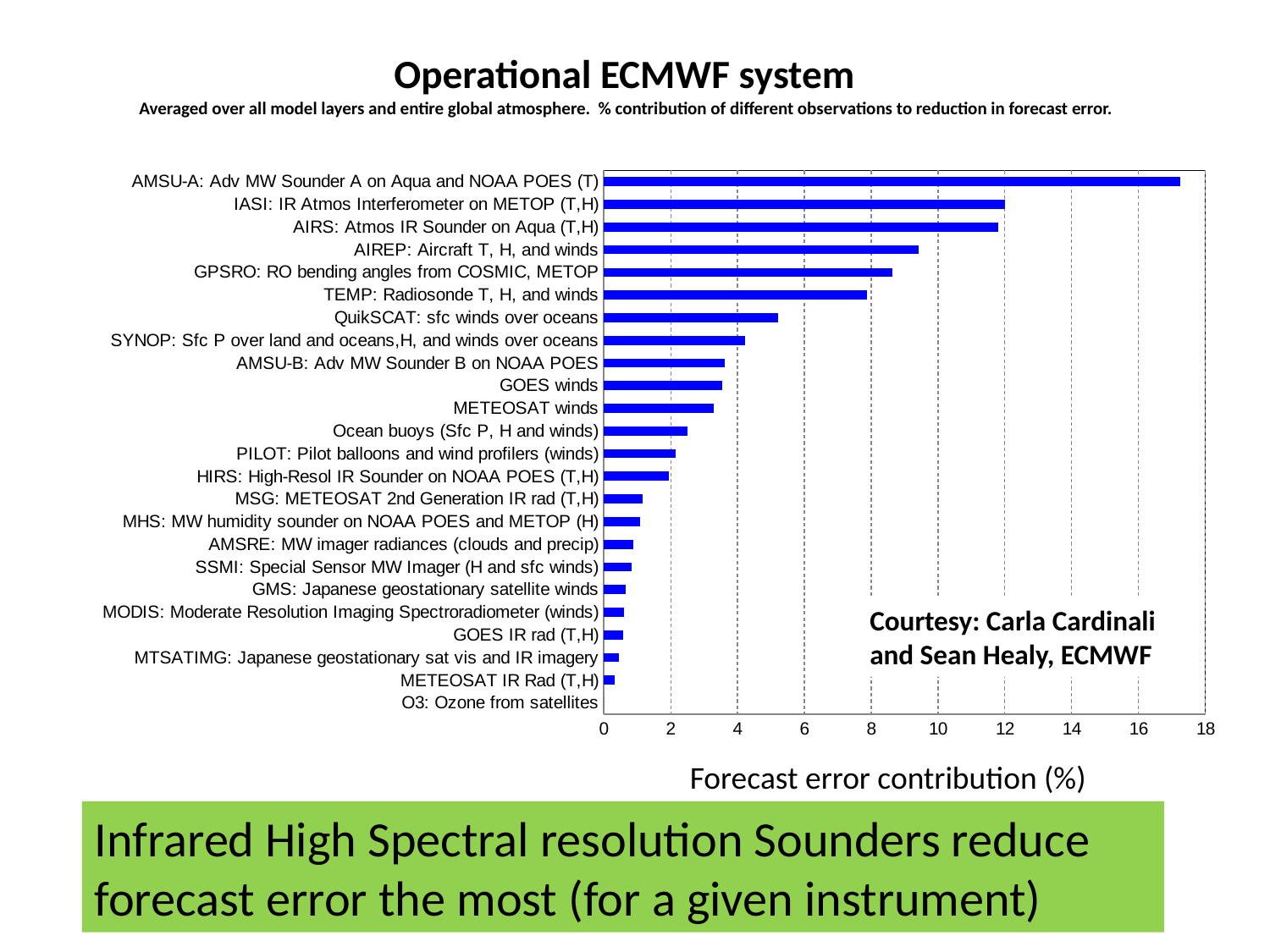
What is the label of the horizontal axis? Forecast error contribution (%) Which has a larger forecast error contribution, AIREP or GPSRO? AIREP Which observation type has the highest forecast error contribution? AMSU-A: Adv MW Sounder A on Aqua and NOAA POES (T) Is the forecast error contribution for QuikSCAT: sfc winds over oceans greater or less than 4? greater Is the forecast error contribution for AIREP: Aircraft T, H, and winds greater or less than 8? greater Is the forecast error contribution for AMSU-B: Adv MW Sounder B on NOAA POES greater or less than 4? less How many observation types are listed on the chart? 24 Which observation type has the lowest forecast error contribution? O3: Ozone from satellites What kind of chart is shown on the slide? bar chart Which has a larger forecast error contribution, AMSU-A or IASI? AMSU-A